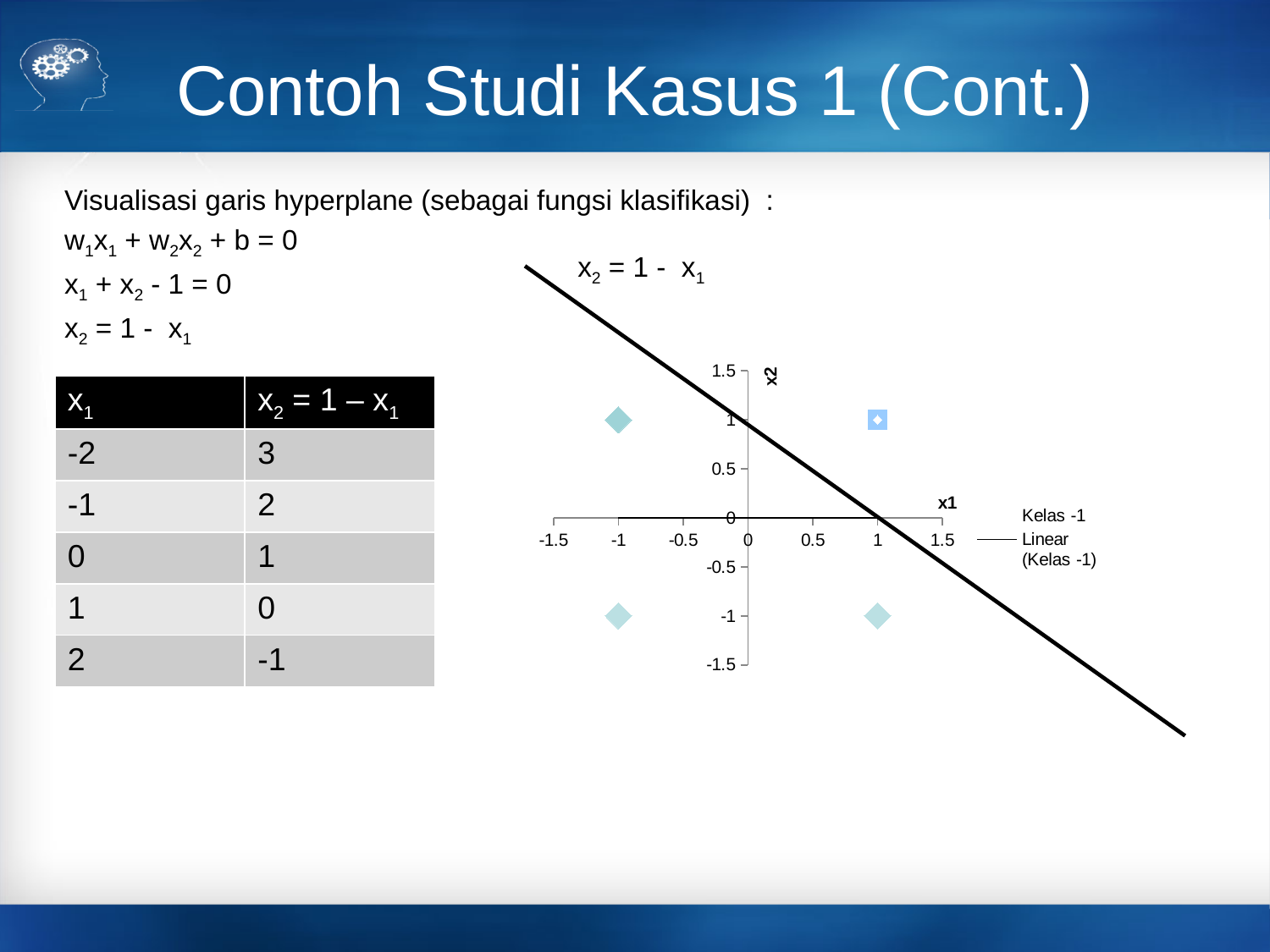
How many data points are plotted on the chart? 4 At what x1 value does the plotted line cross the horizontal axis? 1 Does the plotted line rise or fall as x1 increases? falls How many entries does the chart legend list? 2 What are the two entries in the chart legend? Kelas -1 and Linear (Kelas -1) What is the title of the horizontal axis of the chart? x1 Is the x1 value of the lower-right data point greater or less than 0.5? greater What is the x2 value of the data point plotted at x1 = 1 below the horizontal axis? -1 What is the highest tick value shown on the x2 axis? 1.5 Is the x2 value of the upper-left data point greater or less than 0? greater What is the x2 value of the data point plotted at x1 = -1 above the horizontal axis? 1 What kind of chart is shown on the slide? scatter chart